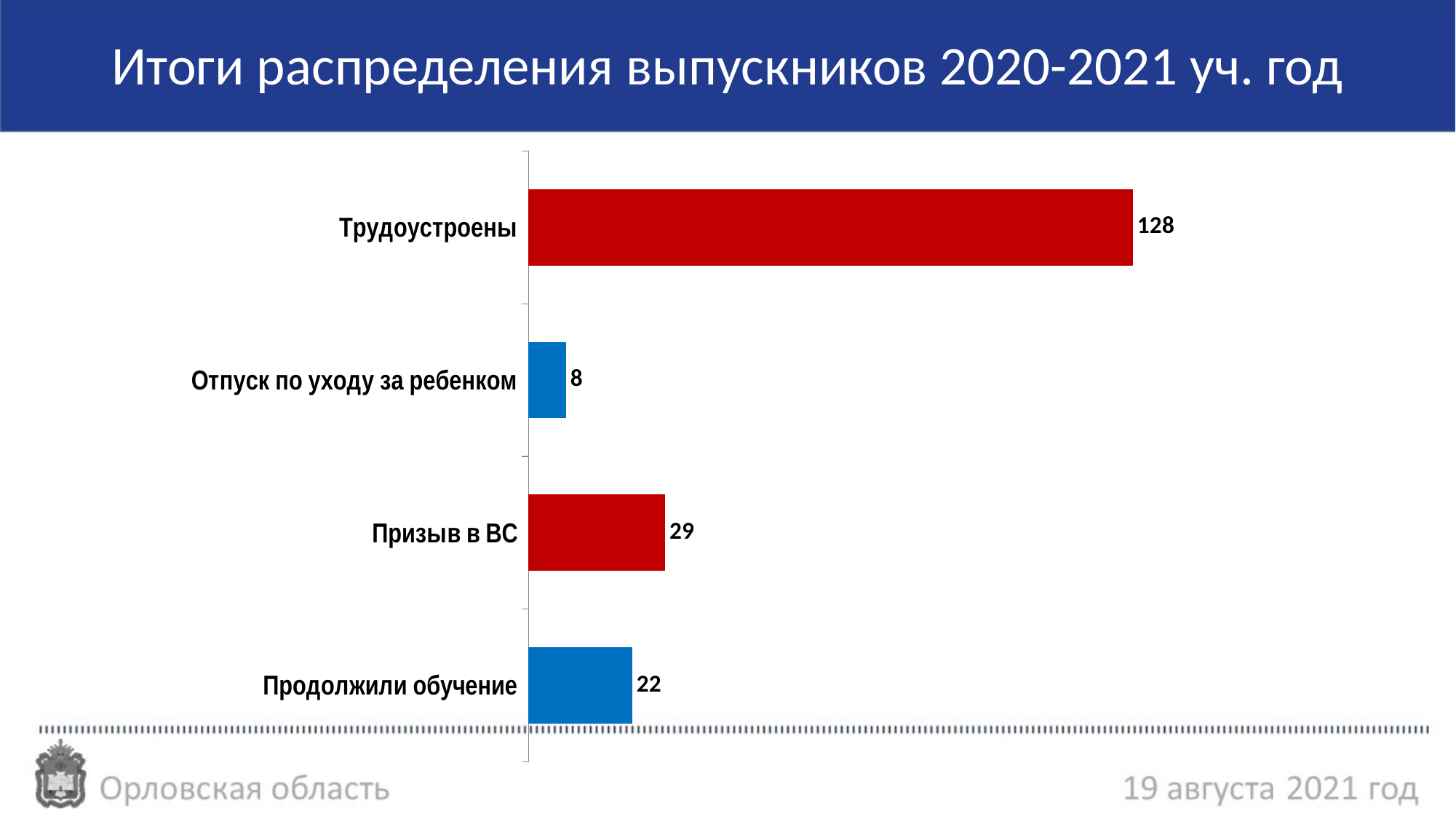
What is the value for Призыв в ВС? 29 How many categories are shown in the chart? 4 What is the value for Трудоустроены? 128 What is the difference between the values for Призыв в ВС and Продолжили обучение? 7 Which is larger, the value for Призыв в ВС or the value for Продолжили обучение? Призыв в ВС Which category has the lowest value? Отпуск по уходу за ребенком What kind of chart is shown on the slide? bar chart What is the value for Продолжили обучение? 22 What is the difference between the values for Трудоустроены and Призыв в ВС? 99 Which category has the highest value? Трудоустроены What is the title of the slide? Итоги распределения выпускников 2020-2021 уч. год What is the value for Отпуск по уходу за ребенком? 8